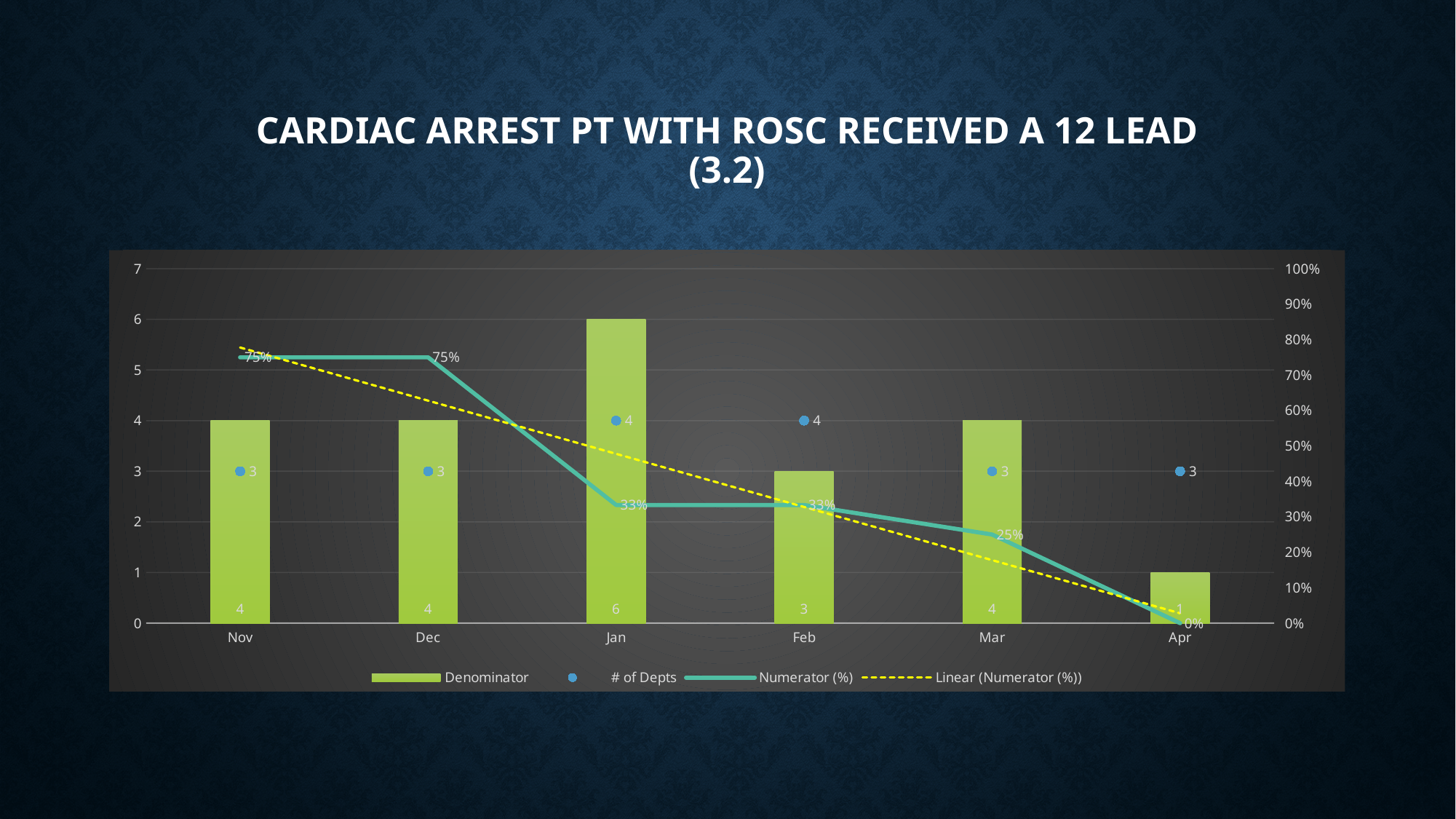
What is the Numerator (%) value for Mar? 25% What is the Denominator value for Jan? 6 Which month has the lowest Denominator value? Apr What is the # of Depts value for Feb? 4 How many series does the legend list? 4 Which is larger, the Numerator (%) for Dec or for Jan? Dec What is the difference between the Denominator values for Jan and Feb? 3 What is the Numerator (%) value for Apr? 0% Does the Numerator (%) line rise or fall from Nov to Apr? fall What is the title of the chart on the slide? CARDIAC ARREST PT WITH ROSC RECEIVED A 12 LEAD (3.2) How many months are shown on the x axis? 6 Which month has the highest Denominator value? Jan